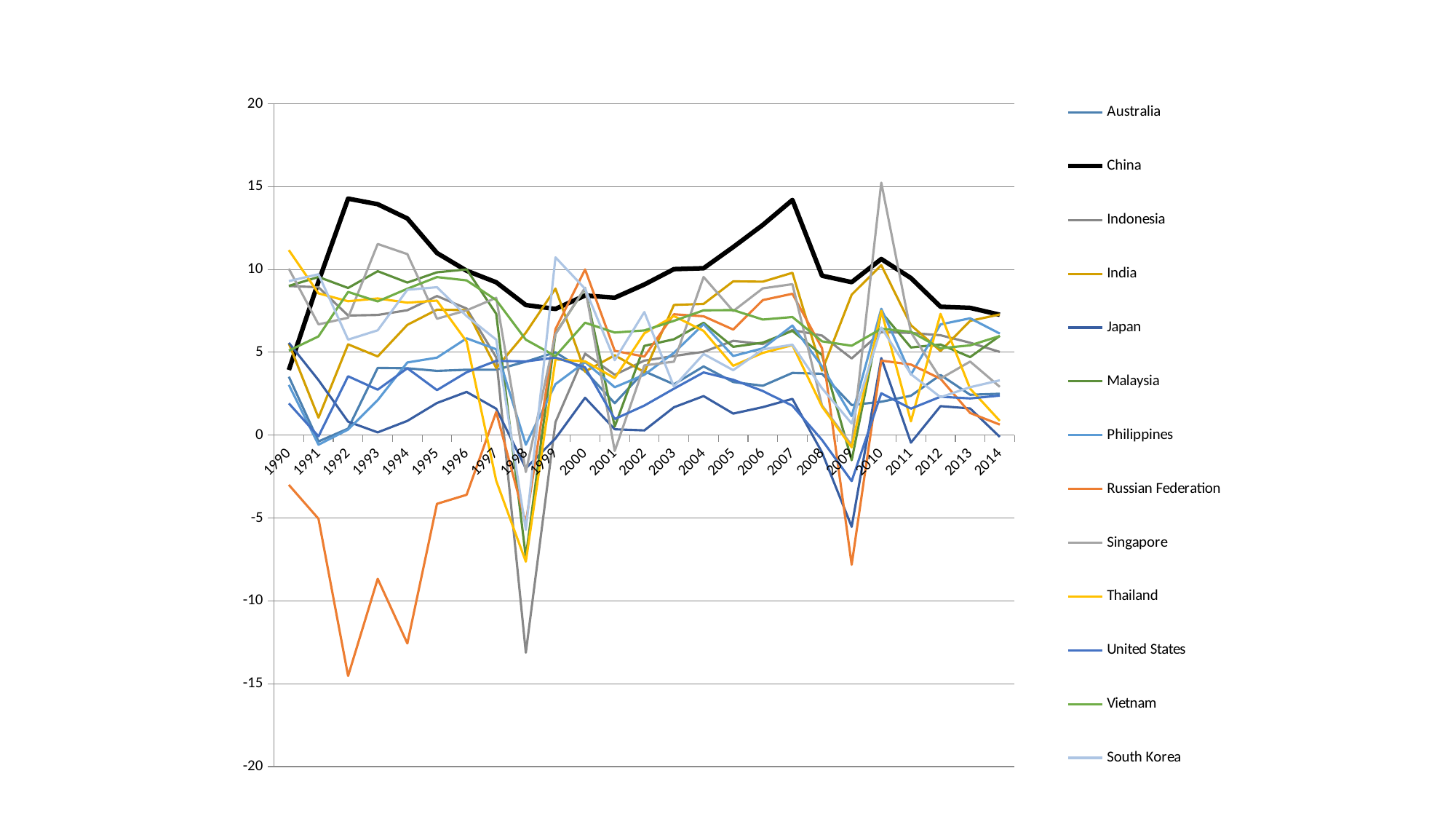
Which series has the highest value in 2010? Singapore Is the value for Russian Federation in 2009 greater or less than -5? less What kind of chart is shown on the slide? line chart Is the value for Russian Federation in 1992 greater or less than -10? less How many series does the legend list? 13 Is the value for Singapore in 1998 greater or less than -10? greater Does the China line rise or fall from 2007 to 2014? fall Which series is drawn with a thick black line? China How many years are shown along the x axis? 25 Which series has the highest value in 1992? China Which series has the lowest value in 1998? Indonesia